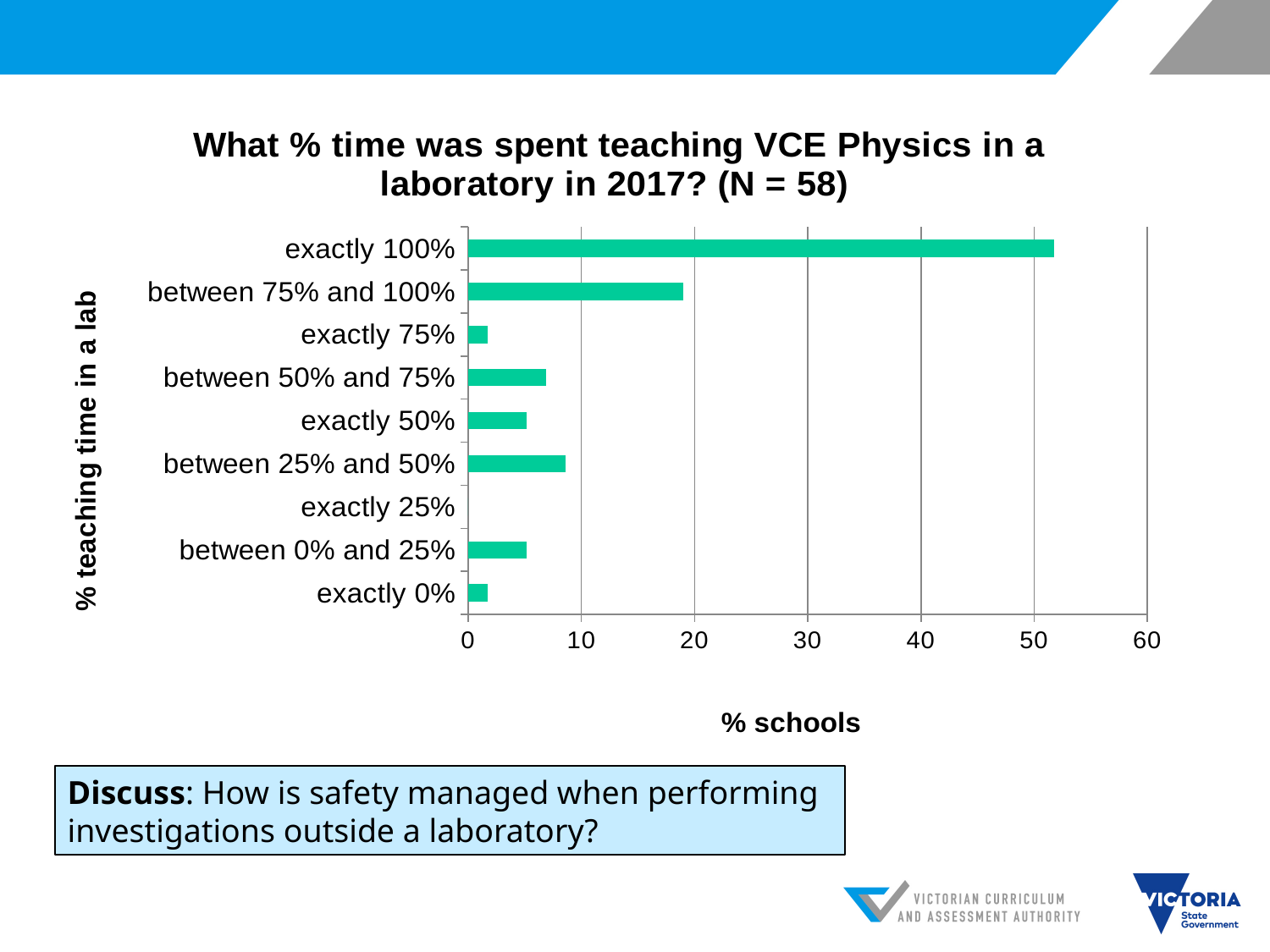
What is the label on the horizontal axis of the chart? % schools Which category has the highest % of schools? exactly 100% Is the value for 'between 25% and 50%' greater or less than 10? less Which is larger, the value for 'between 25% and 50%' or the value for 'exactly 75%'? between 25% and 50% What is the label on the vertical axis of the chart? % teaching time in a lab How many categories are shown on the vertical axis of the chart? 9 Is the value for 'between 75% and 100%' greater or less than 20? less Is the value for 'exactly 100%' greater or less than 50? greater Which category has the lowest % of schools? exactly 25% Which is larger, the value for 'exactly 100%' or the value for 'between 75% and 100%'? exactly 100% What kind of chart is shown on the slide? bar chart